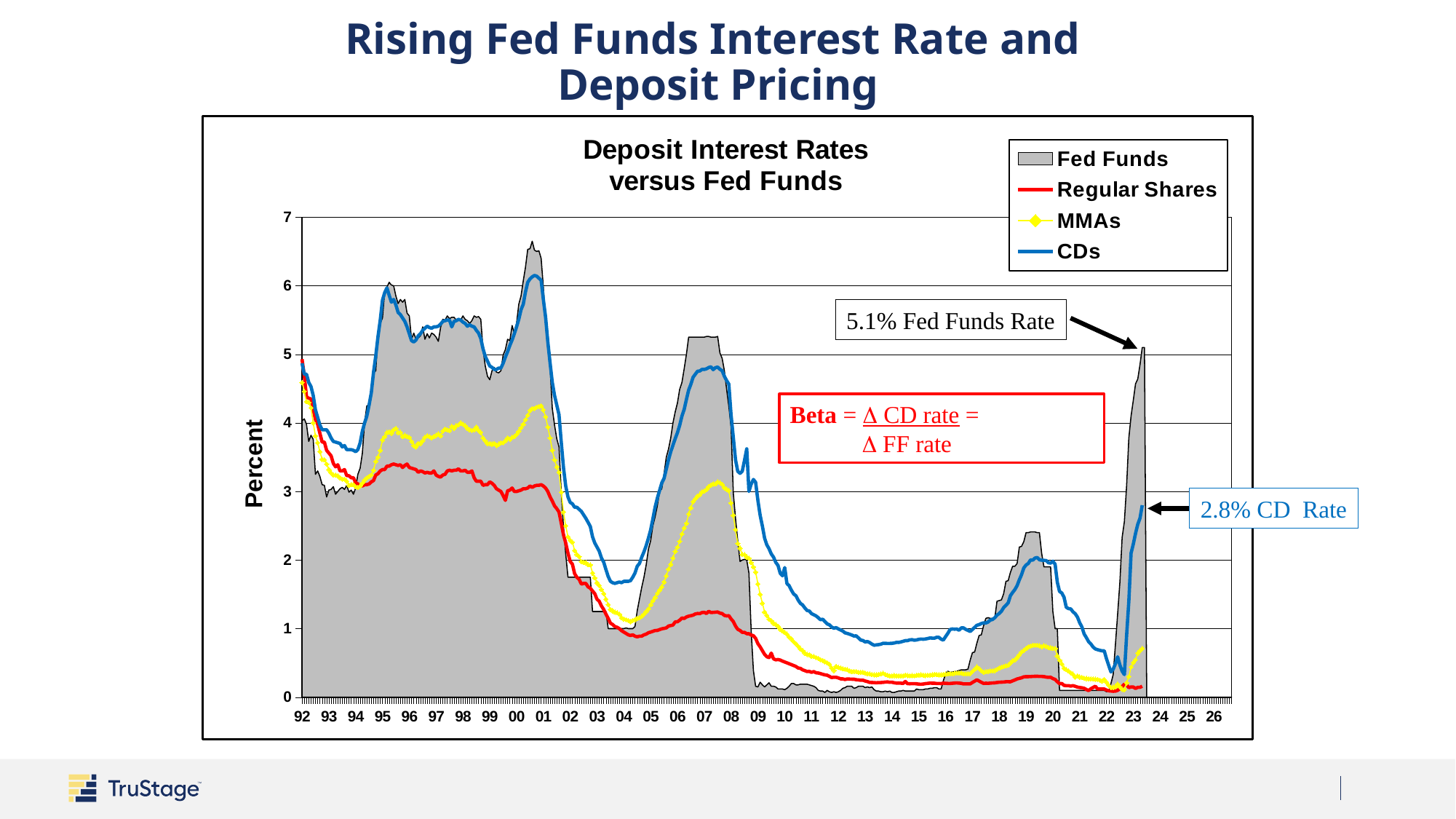
Which series is the lowest around 2013? Fed Funds What kind of chart is shown on the slide? combination area and line chart Around 2007, which series is higher: CDs or Regular Shares? CDs What is the CD rate called out by the annotation at the right end of the chart? 2.8% What is the title of the chart on the slide? Deposit Interest Rates versus Fed Funds What is the Fed Funds rate called out by the annotation at the right end of the chart? 5.1% Does the Fed Funds series rise or fall from 2022 to 2023? rise How many series does the chart's legend list? 4 What is the difference between the annotated 5.1% Fed Funds rate and the annotated 2.8% CD rate? 2.3% Is the CDs value at its 2007 peak greater or less than 5? less Is the Regular Shares value in 2013 greater or less than 1? less Is the peak Fed Funds value around 2001 greater or less than 6? greater